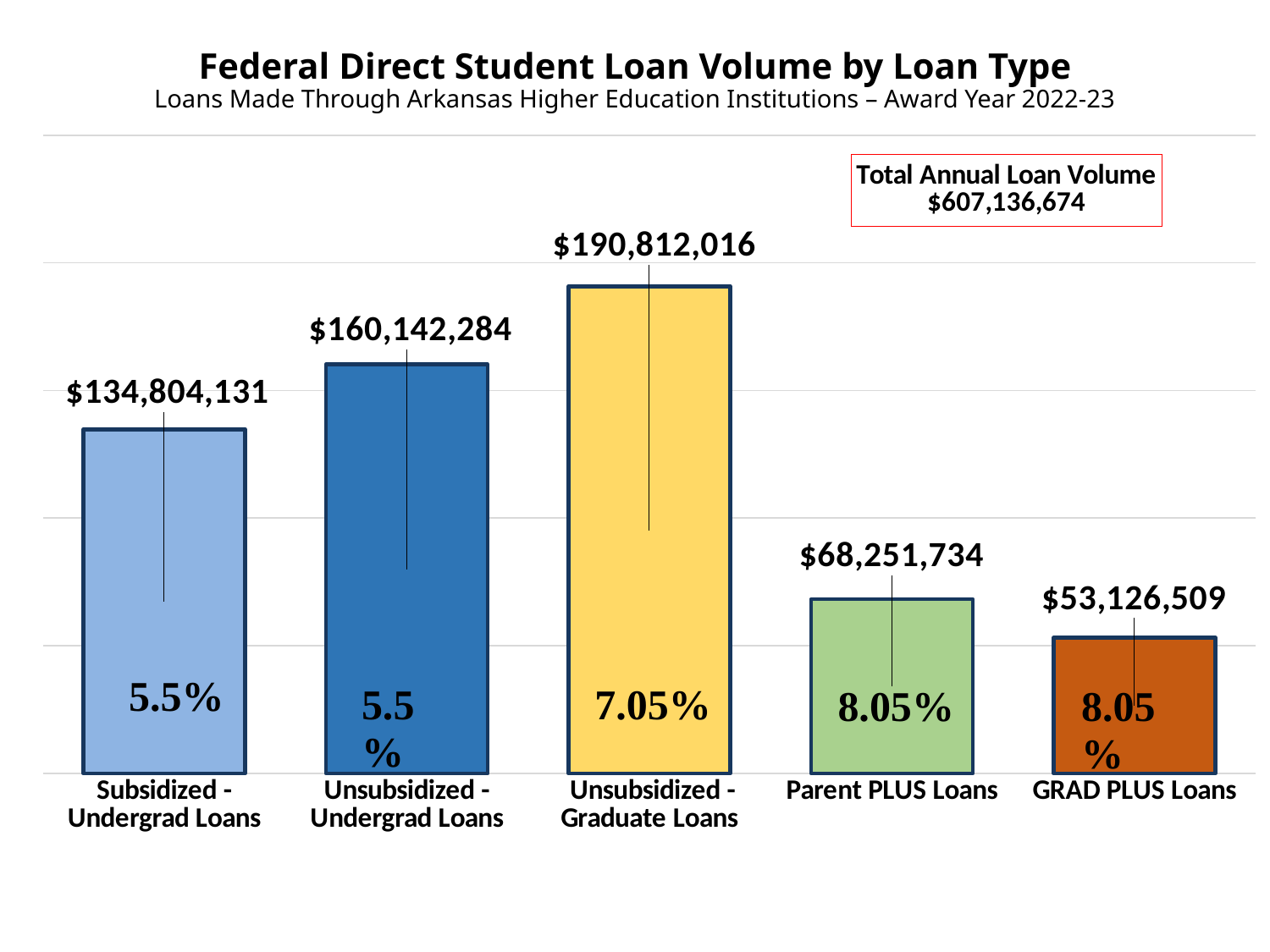
What is the difference in loan volume between Unsubsidized - Graduate Loans and Unsubsidized - Undergrad Loans? $30,669,732 What percentage is printed inside the GRAD PLUS Loans bar? 8.05% Which has a larger loan volume, Subsidized - Undergrad Loans or Unsubsidized - Undergrad Loans? Unsubsidized - Undergrad Loans What is the difference in loan volume between Parent PLUS Loans and GRAD PLUS Loans? $15,125,225 Which loan type has the highest loan volume? Unsubsidized - Graduate Loans Which loan type has the lowest loan volume? GRAD PLUS Loans What is the Total Annual Loan Volume shown in the box on the slide? $607,136,674 How many loan types are shown in the chart? 5 What is the loan volume for Unsubsidized - Graduate Loans? $190,812,016 What is the loan volume for Subsidized - Undergrad Loans? $134,804,131 What kind of chart is shown on the slide? Bar chart What is the loan volume for Parent PLUS Loans? $68,251,734